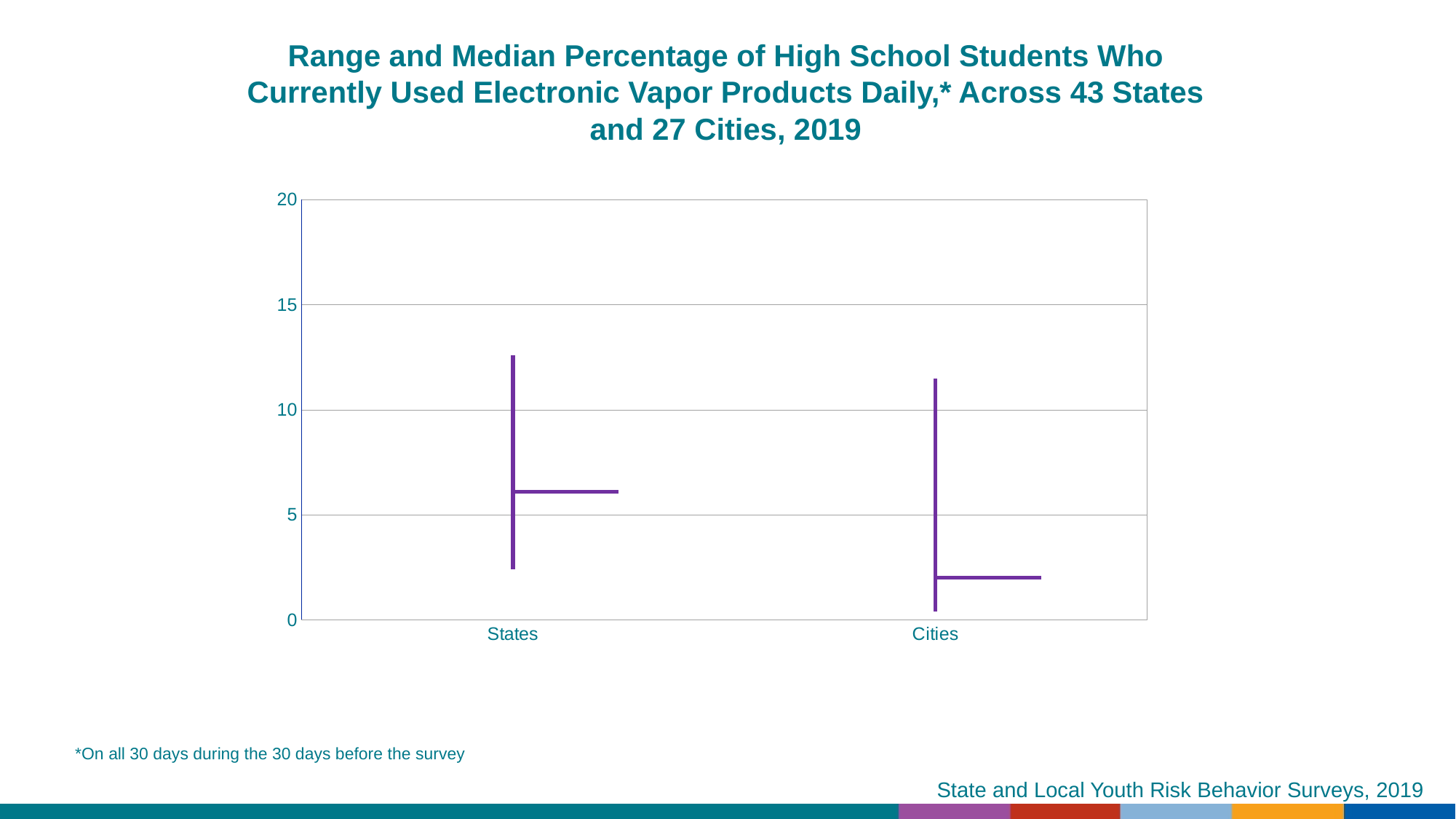
What is the highest value shown on the y axis of the chart? 20 Which category has the higher maximum value in its range, States or Cities? States Is the top of the range for Cities greater or less than 10? greater Which category has the higher median percentage, States or Cities? States How many categories are shown on the x axis of the chart? 2 Is the bottom of the range for States greater or less than 5? less Is the median value for Cities greater or less than 5? less Which category has the lower minimum value in its range, States or Cities? Cities According to the chart title, how many states and how many cities are included? 43 states and 27 cities